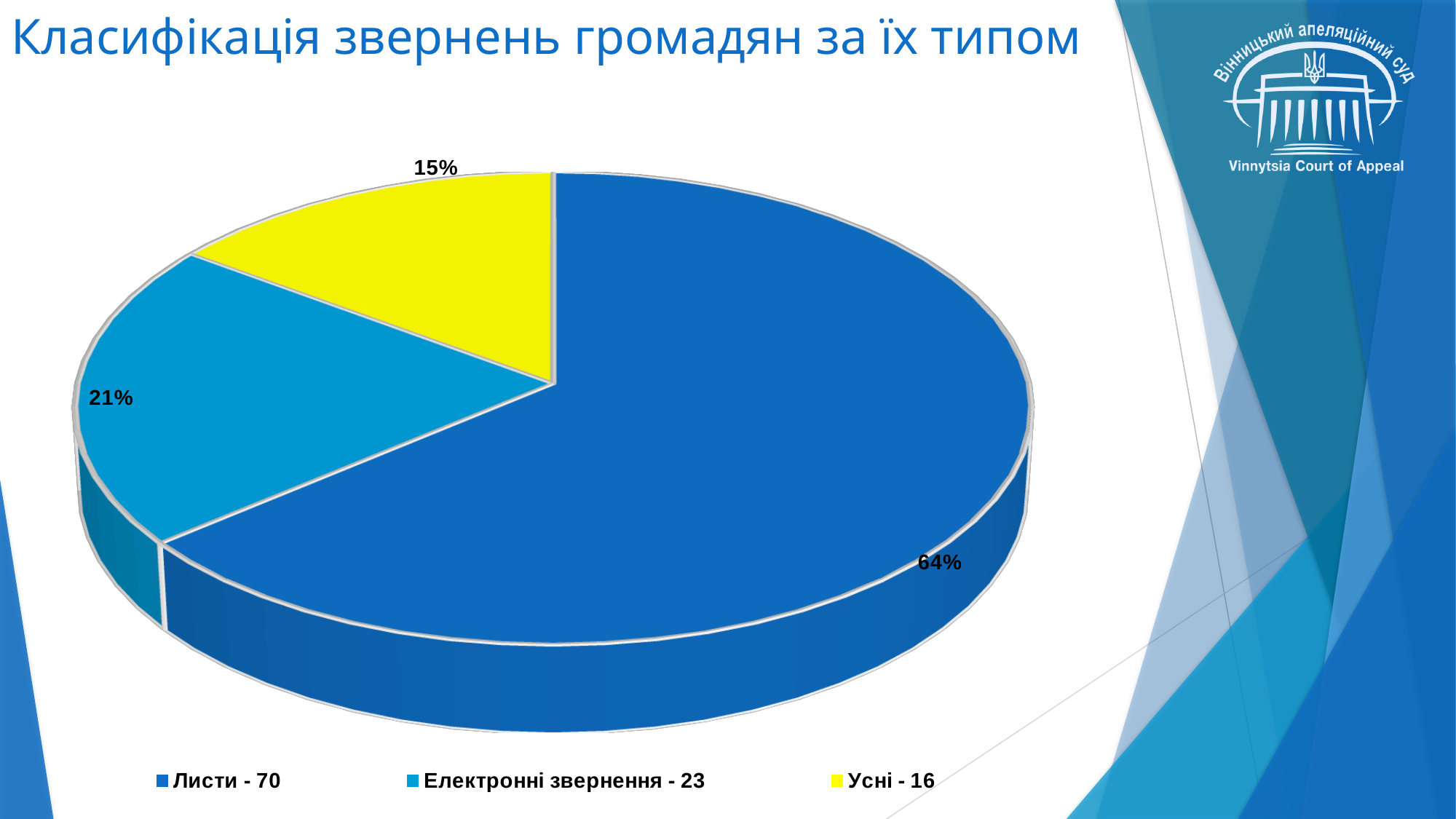
What percentage share does the "Електронні звернення - 23" slice have? 21% What percentage share does the "Листи - 70" slice have? 64% What colour is the "Усні - 16" slice? yellow What kind of chart is shown on the slide? pie chart Which category has the smallest slice of the pie? Усні - 16 What is the difference in percentage points between the "Листи - 70" slice and the "Електронні звернення - 23" slice? 43 How many entries does the legend list? 3 Which slice is larger, "Електронні звернення - 23" or "Усні - 16"? Електронні звернення - 23 What is the title of the chart on the slide? Класифікація звернень громадян за їх типом What percentage share does the "Усні - 16" slice have? 15% Which category has the largest slice of the pie? Листи - 70 How many slices does the pie chart have? 3